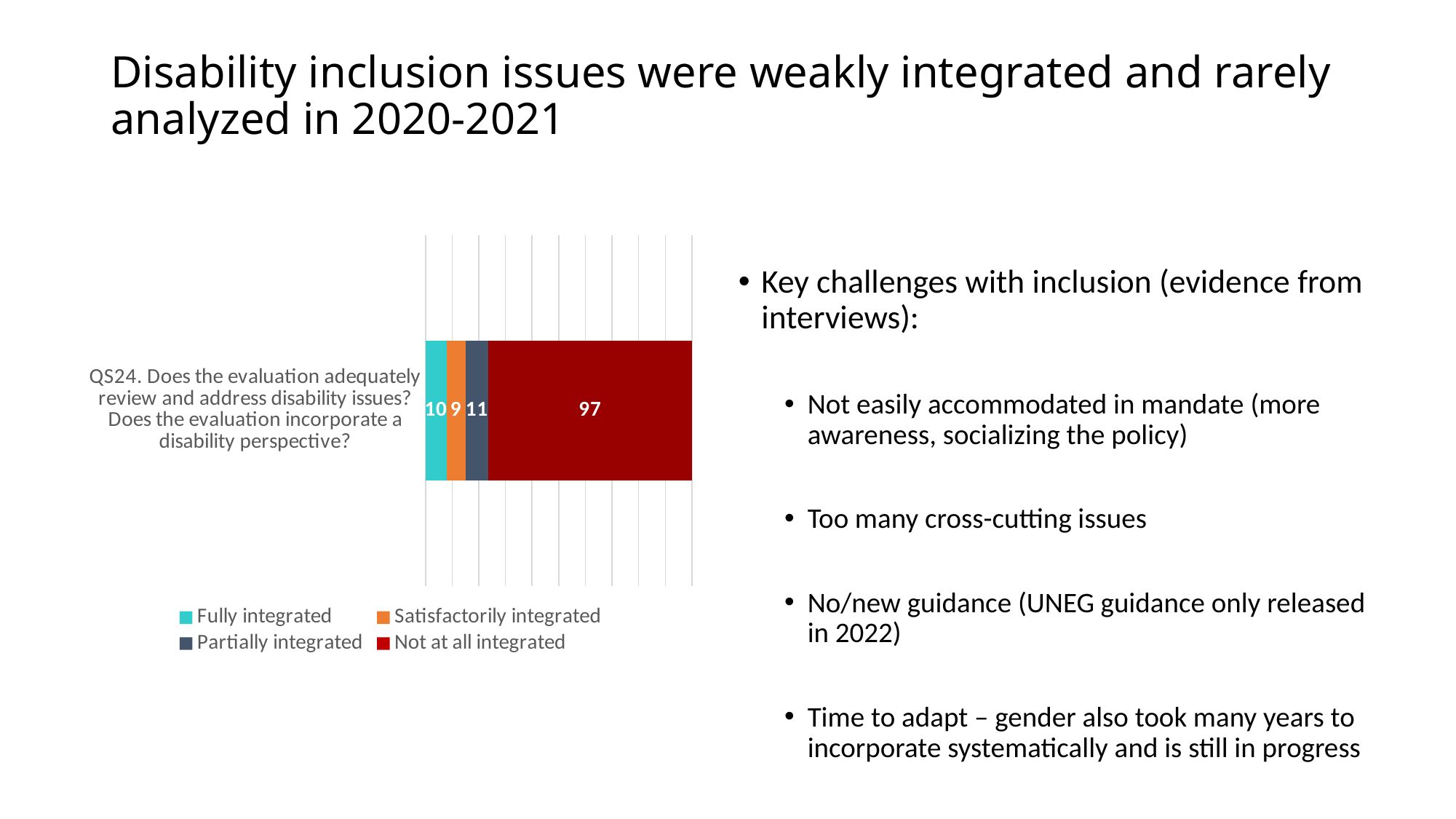
Which series has the highest value in the chart? Not at all integrated What colour represents 'Not at all integrated' in the chart? Dark red Which is larger, the value for 'Fully integrated' or the value for 'Partially integrated'? Partially integrated Which series has the lowest value in the chart? Satisfactorily integrated What is the value for 'Partially integrated' in the chart? 11 What is the value for 'Satisfactorily integrated' in the chart? 9 What is the value for 'Not at all integrated' in the chart? 97 What is the value for 'Fully integrated' in the chart? 10 What is the difference between the 'Not at all integrated' value and the 'Partially integrated' value? 86 How many series does the legend list? 4 What is the total of the stacked bar in the chart? 127 What kind of chart is shown on the slide? Stacked bar chart